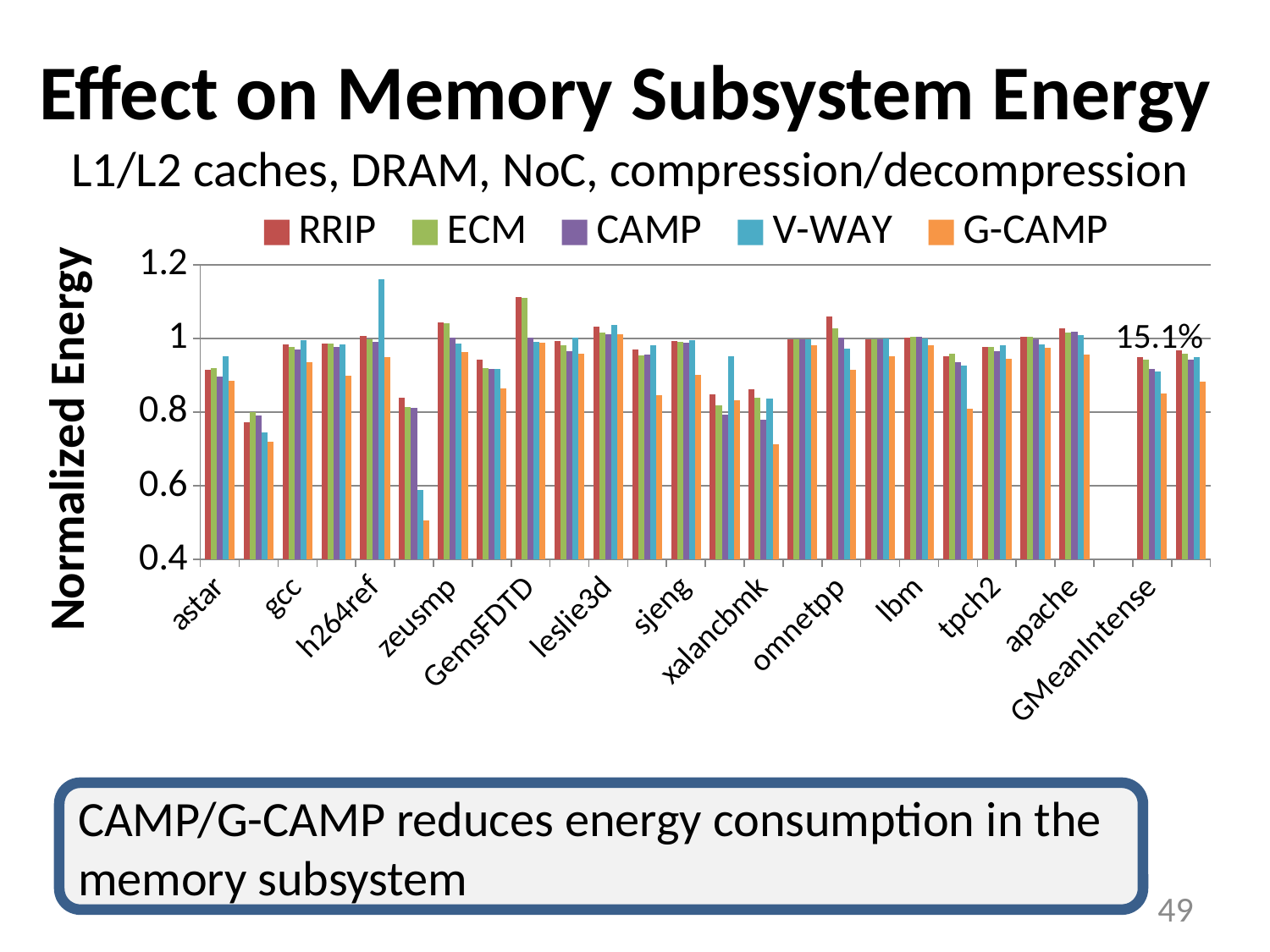
Is the V-WAY value for zeusmp greater or less than 0.8? greater Which series has the lowest bar for zeusmp? G-CAMP Which series has the highest bar for h264ref? V-WAY Is the G-CAMP value for zeusmp greater or less than 0.6? greater Is the G-CAMP value for xalancbmk greater or less than 0.8? less What kind of chart is shown on the slide? bar chart How many series does the legend list? 5 For zeusmp, which is larger: the RRIP value or the G-CAMP value? RRIP What is the label of the y axis? Normalized Energy What percentage annotation is printed near the GMeanIntense bars? 15.1%